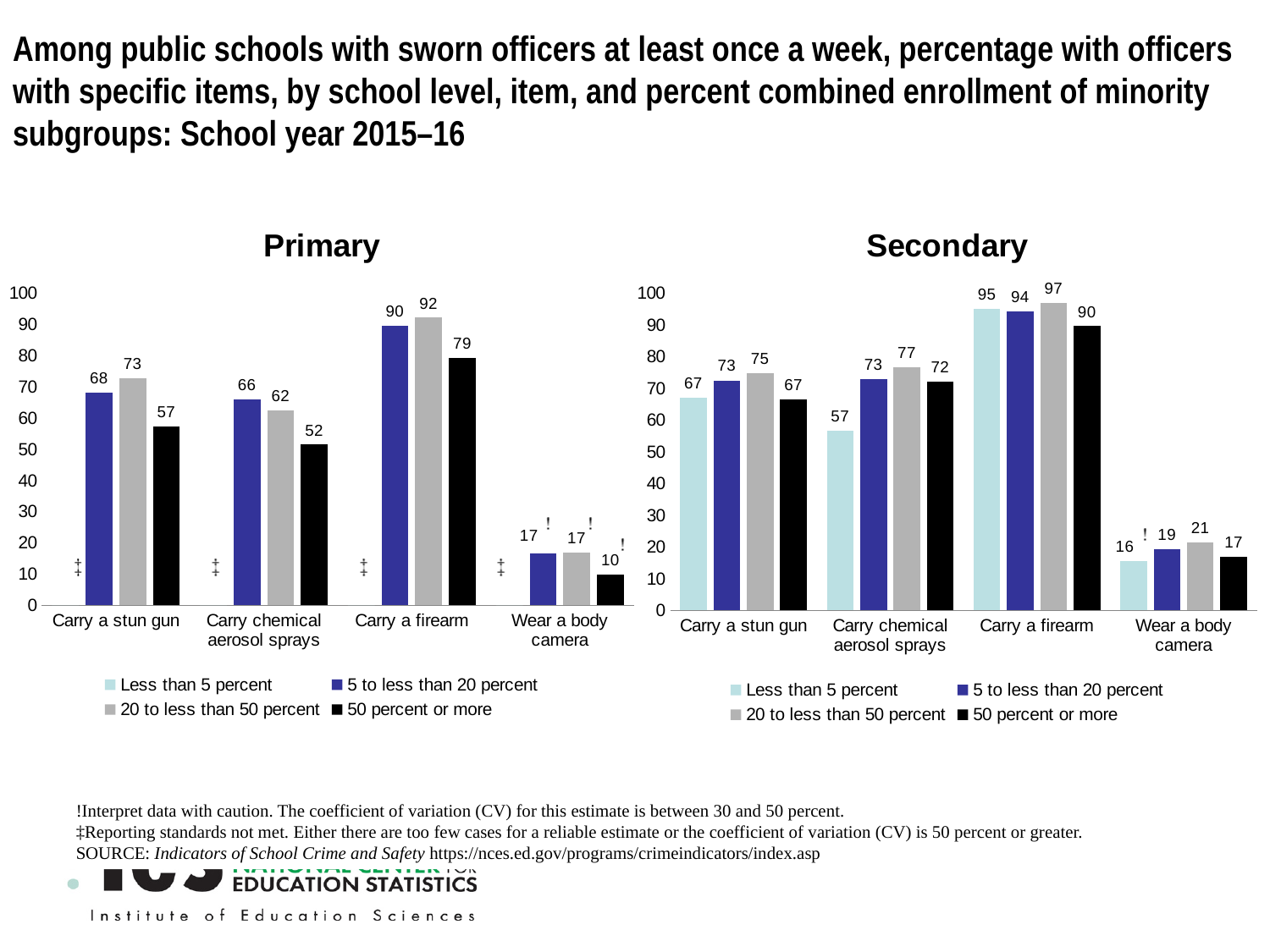
What type of chart is the Secondary chart? Bar chart In the Secondary chart, which is larger for 'Carry chemical aerosol sprays': the 'Less than 5 percent' value or the '50 percent or more' value? 50 percent or more In the Secondary chart, what is the value for 'Carry chemical aerosol sprays' for the 'Less than 5 percent' series? 57 In the Secondary chart, what is the difference between the '20 to less than 50 percent' and '50 percent or more' values for 'Carry a firearm'? 7 In the Secondary chart, what is the value for 'Wear a body camera' for the '20 to less than 50 percent' series? 21 In the Primary chart, what is the value for 'Carry a firearm' for the '20 to less than 50 percent' series? 92 In the Secondary chart, which item has the lowest value for the '5 to less than 20 percent' series? Wear a body camera How many item categories are shown on the x axis of the Primary chart? 4 How many series does the legend of the Secondary chart list? 4 In the Primary chart, which item has the highest value for the '50 percent or more' series? Carry a firearm In the Primary chart, what is the difference between the '5 to less than 20 percent' and '50 percent or more' values for 'Carry a stun gun'? 11 In the Primary chart, is the value for 'Carry chemical aerosol sprays' in the '50 percent or more' series greater or less than 60? less